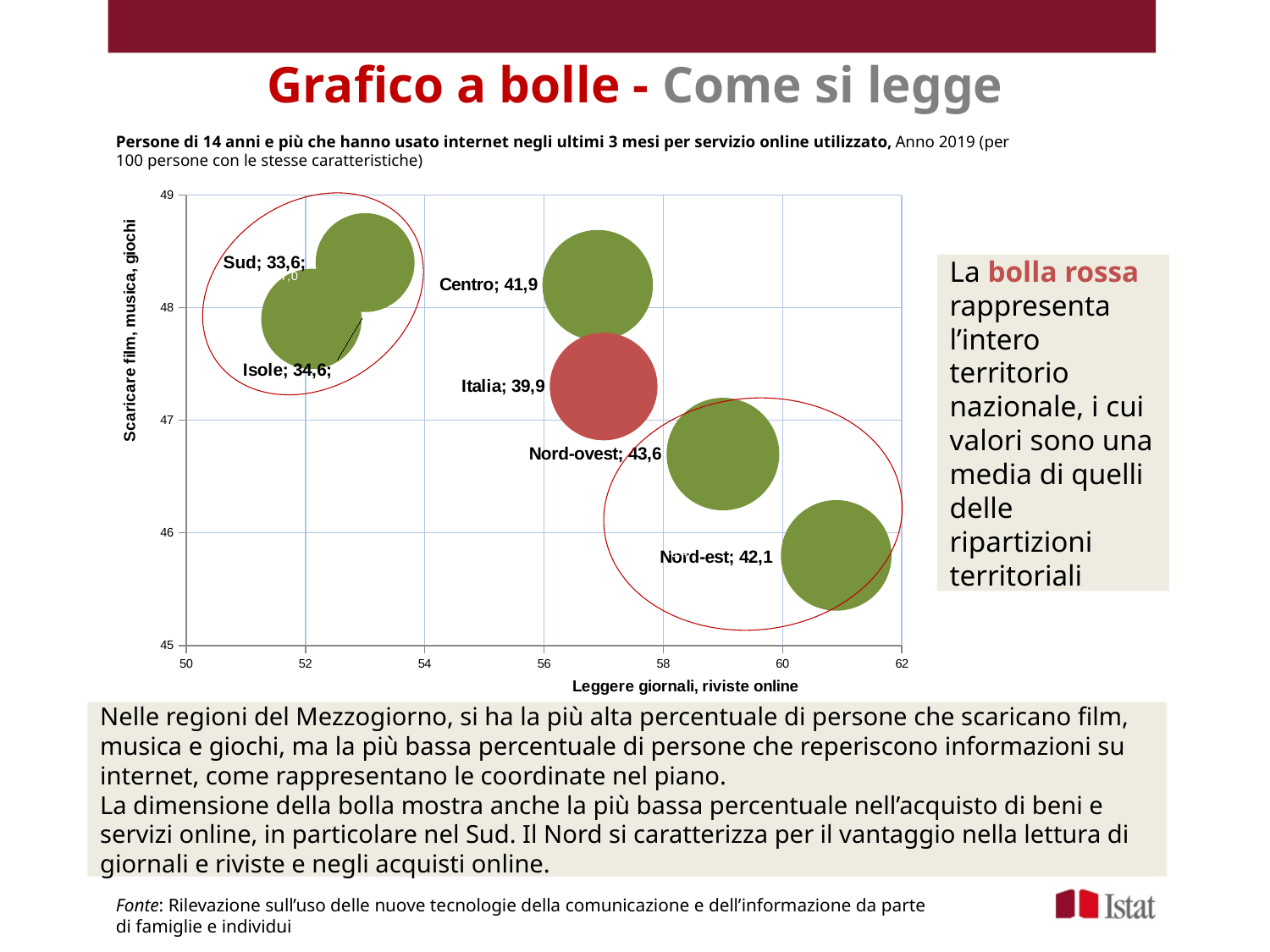
What value is printed in the data label for Nord-ovest? 43,6 What value is printed in the data label for Sud? 33,6 Which labelled bubble has the highest printed value? Nord-ovest Which has the larger printed value, Centro or Italia? Centro On the vertical axis (Scaricare film, musica, giochi), is the Nord-est bubble positioned greater or less than 47? less What value is printed in the data label for Italia? 39,9 On the horizontal axis (Leggere giornali, riviste online), is the Nord-est bubble positioned greater or less than 60? greater What is the difference between the printed values for Nord-ovest and Sud? 10,0 How many bubbles are plotted in the chart? 6 What kind of chart is shown on the slide? bubble chart Which territory is represented by the red bubble? Italia Which labelled bubble has the lowest printed value? Sud